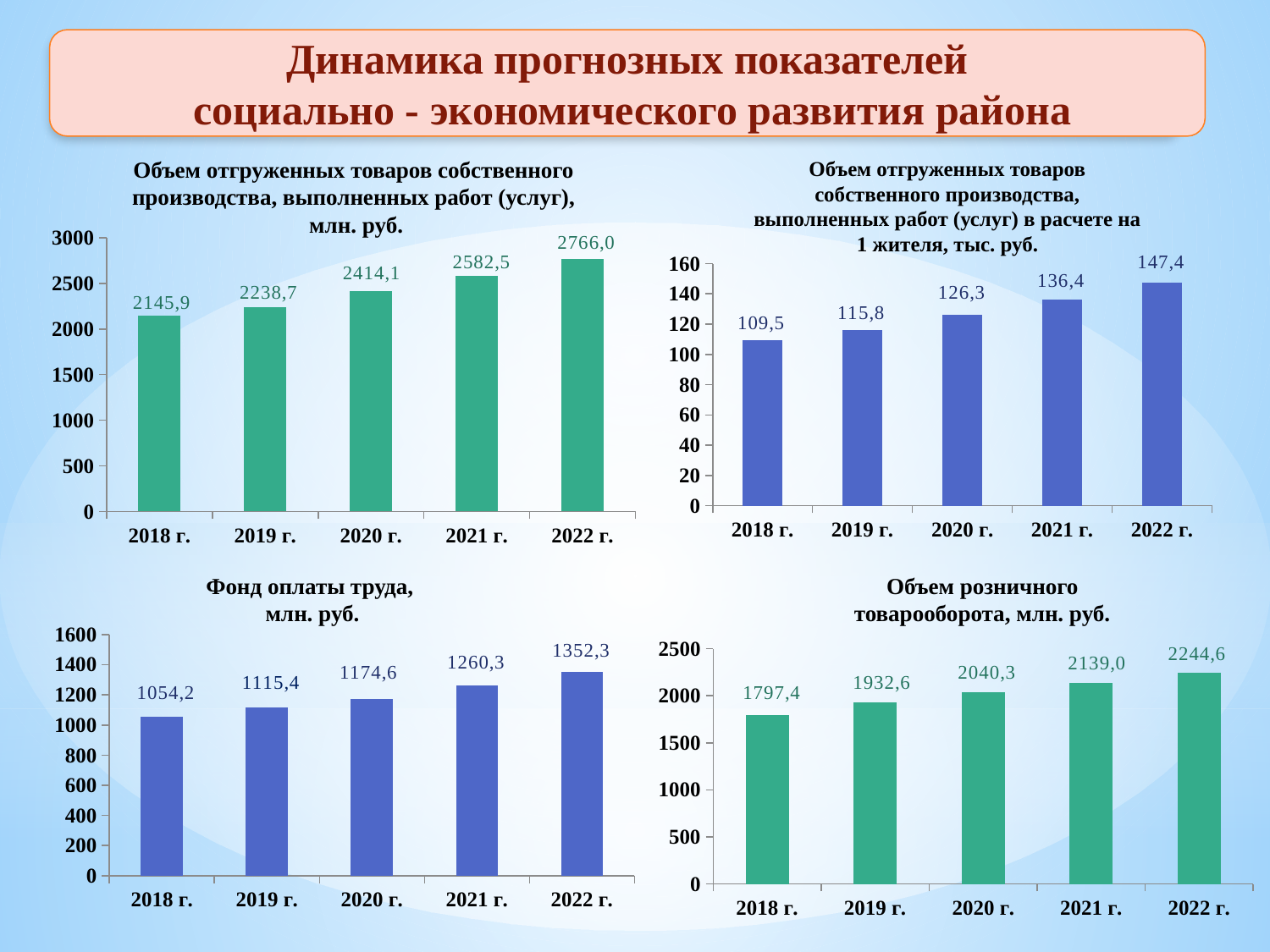
In the top-right chart (в расчете на 1 жителя, тыс. руб.), which is larger: the value for 2019 г. or 2020 г.? 2020 г. In the bottom-left chart (Фонд оплаты труда), which year has the lowest value? 2018 г. In the bottom-right chart (Объем розничного товарооборота), is the value for 2018 г. greater or less than 2000? less In the top-right chart (в расчете на 1 жителя, тыс. руб.), do the values rise or fall from 2018 г. to 2022 г.? rise In the top-right chart (в расчете на 1 жителя, тыс. руб.), what is the value for 2021 г.? 136,4 In the top-left chart (Объем отгруженных товаров, млн. руб.), which year has the highest value? 2022 г. In the top-left chart (Объем отгруженных товаров собственного производства, млн. руб.), what is the value for 2020 г.? 2414,1 How many years are shown on the x axis of the bottom-left chart (Фонд оплаты труда)? 5 In the top-left chart (Объем отгруженных товаров, млн. руб.), what is the difference between the values for 2022 г. and 2018 г.? 620,1 In the bottom-right chart (Объем розничного товарооборота, млн. руб.), what is the value for 2019 г.? 1932,6 In the bottom-right chart (Объем розничного товарооборота), what is the difference between the values for 2022 г. and 2021 г.? 105,6 In the bottom-left chart (Фонд оплаты труда, млн. руб.), what is the value for 2018 г.? 1054,2